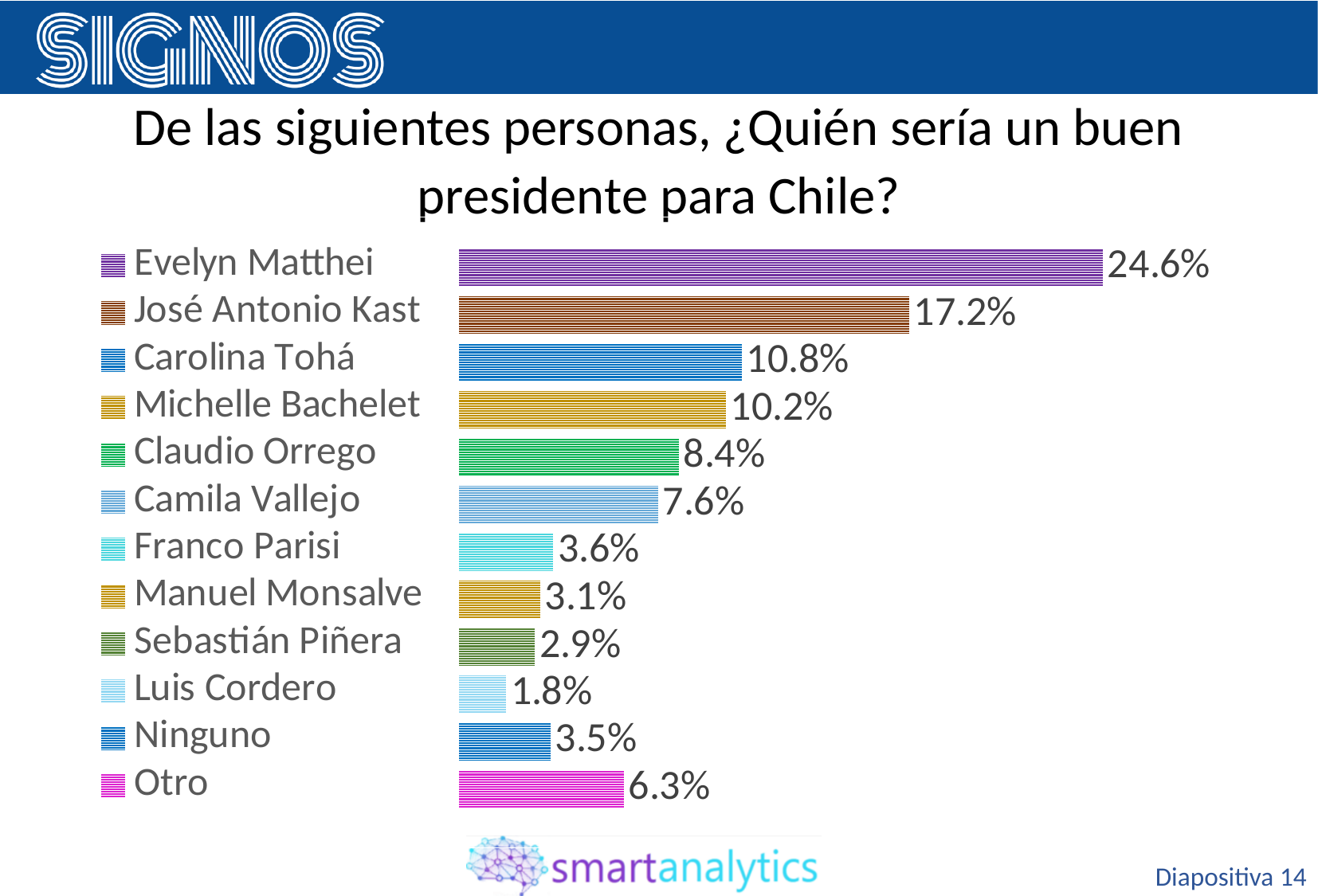
What percentage is shown for Otro? 6.3% Which person has the highest percentage? Evelyn Matthei Who has a higher percentage, Claudio Orrego or Camila Vallejo? Claudio Orrego What colour is the bar for Otro? Magenta What percentage is shown for Ninguno? 3.5% What is the difference in percentage points between Evelyn Matthei and José Antonio Kast? 7.4 Which category has the lowest percentage? Luis Cordero What percentage is shown for Michelle Bachelet? 10.2% What kind of chart is shown on the slide? Bar chart What is the difference in percentage points between Carolina Tohá and Michelle Bachelet? 0.6 What percentage is shown for Evelyn Matthei? 24.6% How many categories are shown in the chart? 12